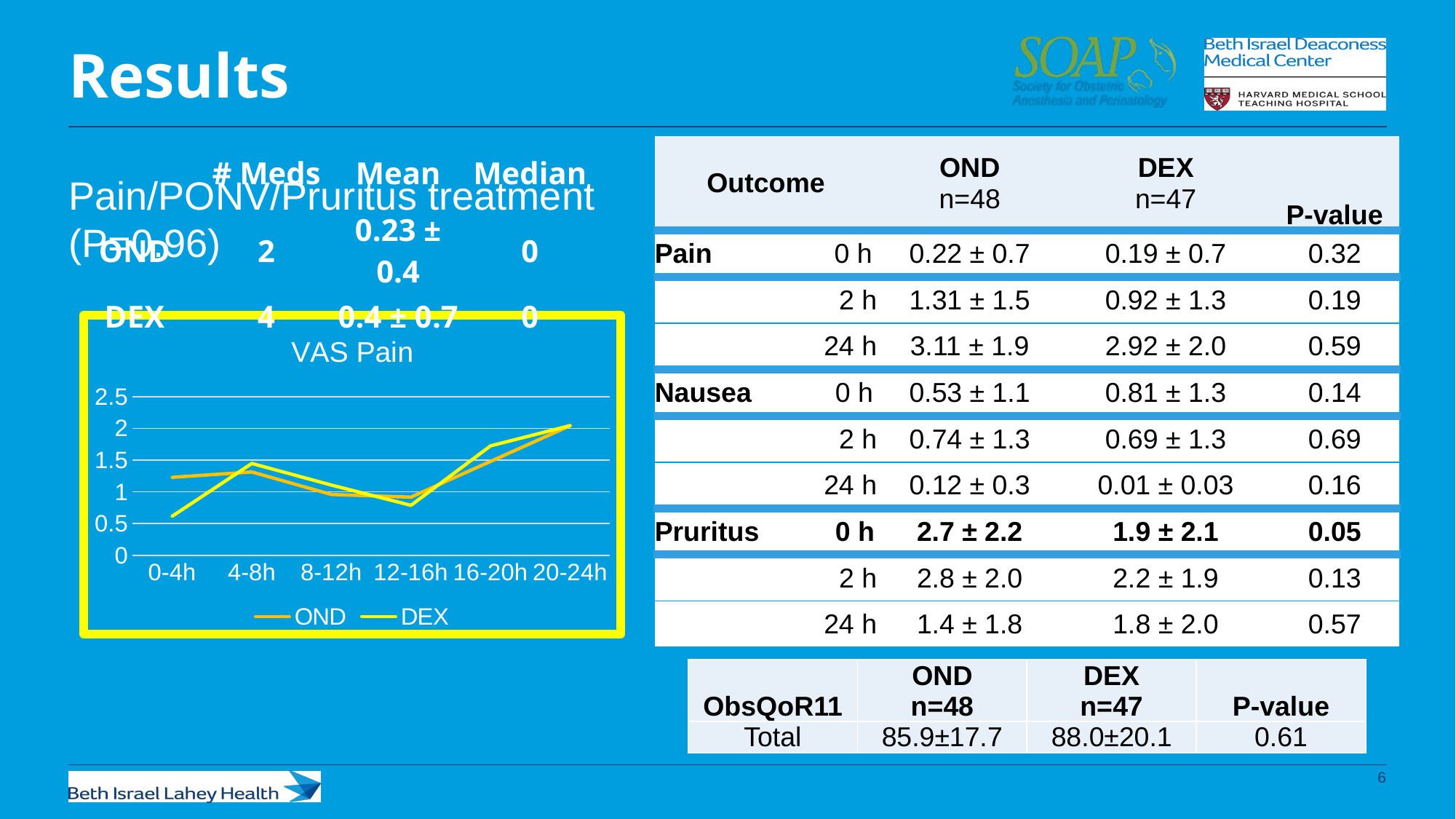
In the VAS Pain chart, is the DEX value at 12-16h greater or less than 1? less How many time intervals are shown on the x axis of the VAS Pain chart? 6 In the VAS Pain chart, is the DEX value at 20-24h greater or less than 1.5? greater In the VAS Pain chart, at which time interval does the DEX series reach its highest value? 20-24h In the VAS Pain chart, do the OND and DEX values rise or fall from 12-16h to 20-24h? rise What kind of chart is the VAS Pain chart? line chart In the VAS Pain chart, is the DEX value at 0-4h greater or less than 1? less How many series does the legend of the VAS Pain chart list? 2 Which series in the VAS Pain chart is drawn in bright yellow? DEX In the VAS Pain chart, which series has the higher value at 0-4h, OND or DEX? OND What is the title of the line chart on the slide? VAS Pain